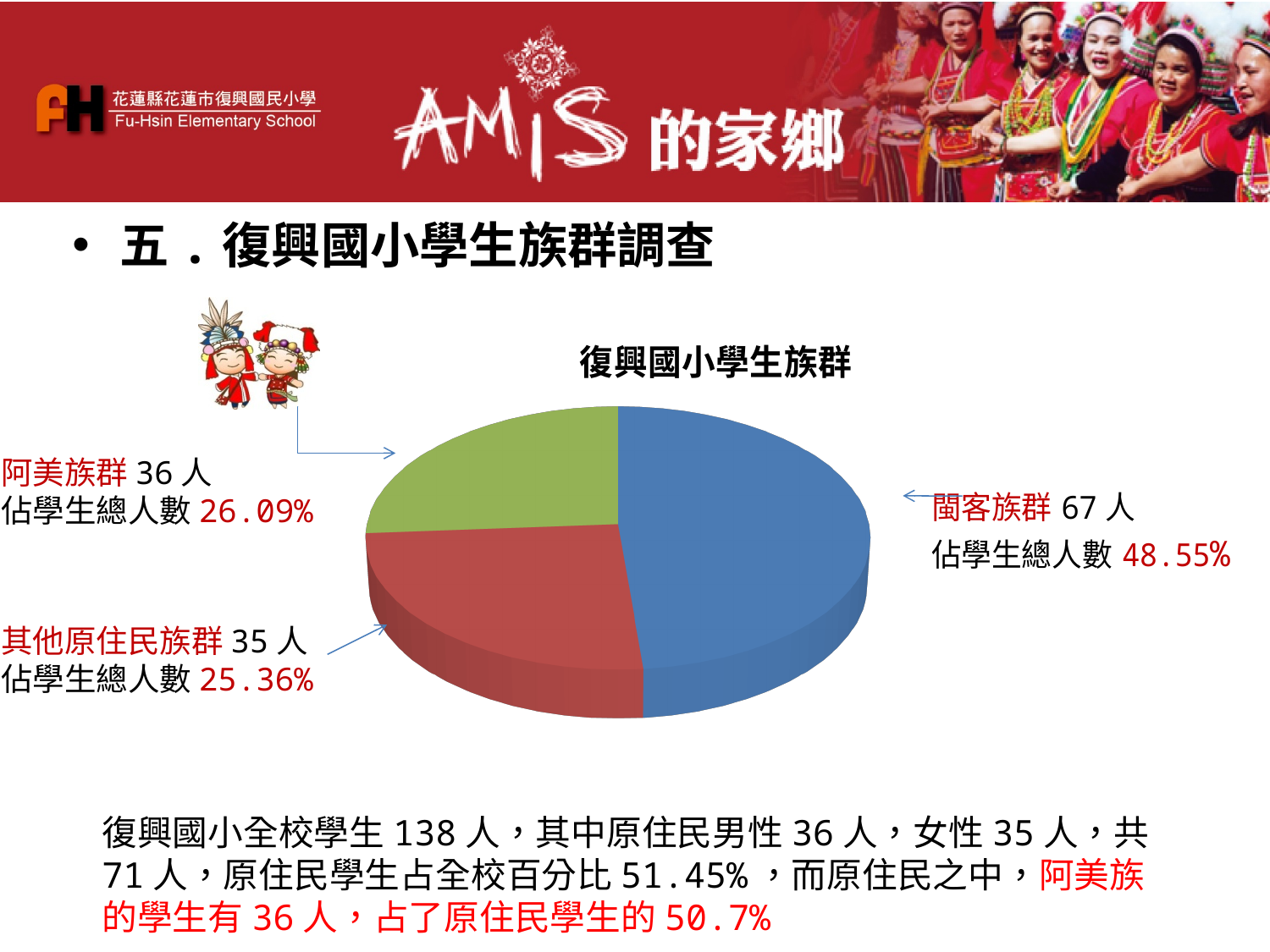
What share of the total students does 阿美族群 represent? 26.09% What share of the total students does 其他原住民族群 represent? 25.36% How many slices does the pie chart have? 3 How many students are in the 閩客族群 group? 67 人 What is the title of the chart? 復興國小學生族群 What share of the total students does 閩客族群 represent? 48.55% How many students are in the 其他原住民族群 group? 35 人 What is the difference in student numbers between 閩客族群 and 阿美族群? 31 人 Which group has the largest slice of the pie? 閩客族群 Which colour is used for the 閩客族群 slice? blue What type of chart is shown on the slide? pie chart How many students are in the 阿美族群 group? 36 人